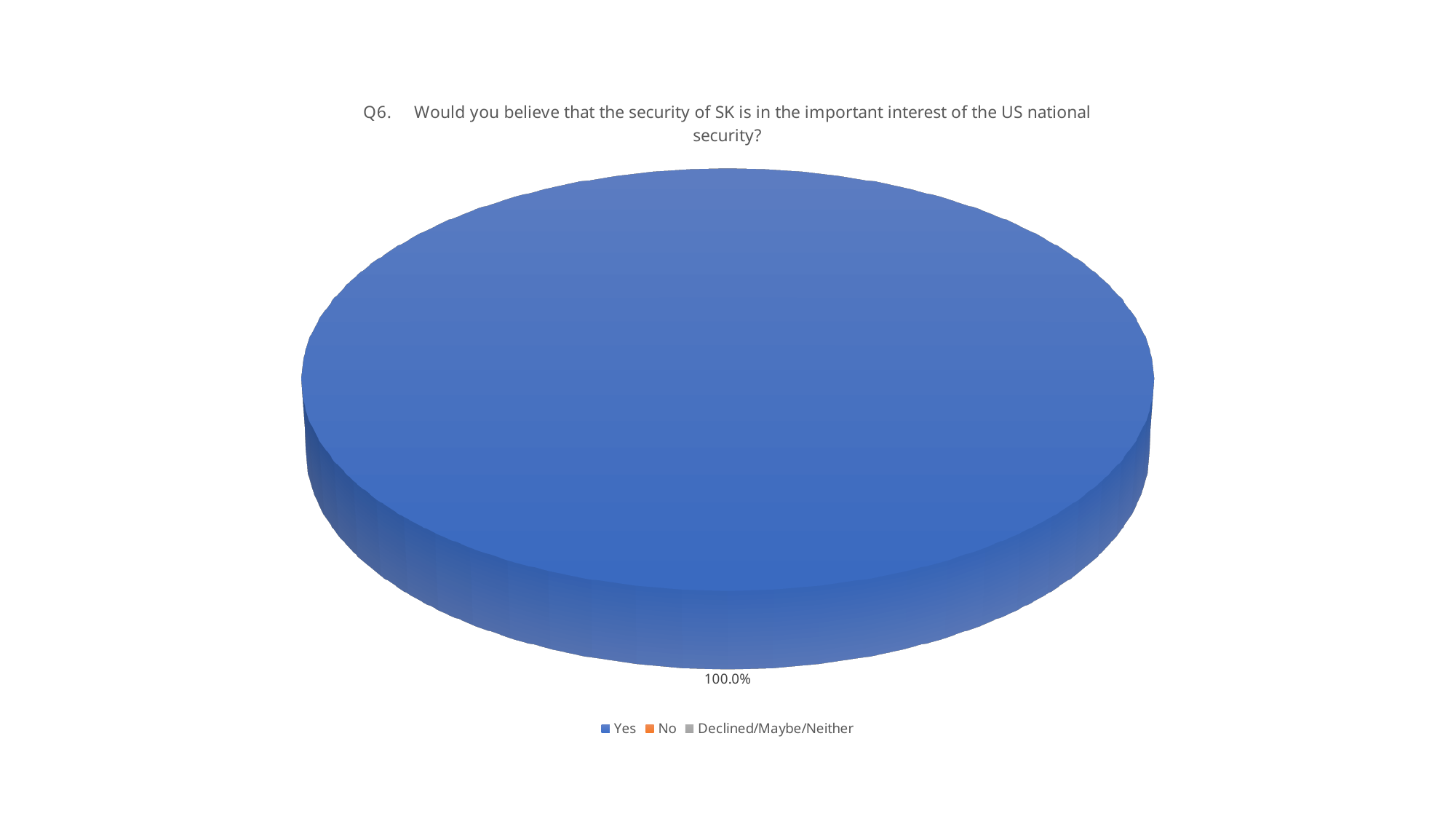
Is the share for Yes larger than the share for No? Yes How many entries does the legend list? 3 What is the only data label printed on the pie? 100.0% Which legend entry is shown in blue? Yes Which category has the largest share of the pie? Yes What is the third entry listed in the legend? Declined/Maybe/Neither What kind of chart is shown on the slide? pie chart What share of the pie does the Yes slice take? 100.0%